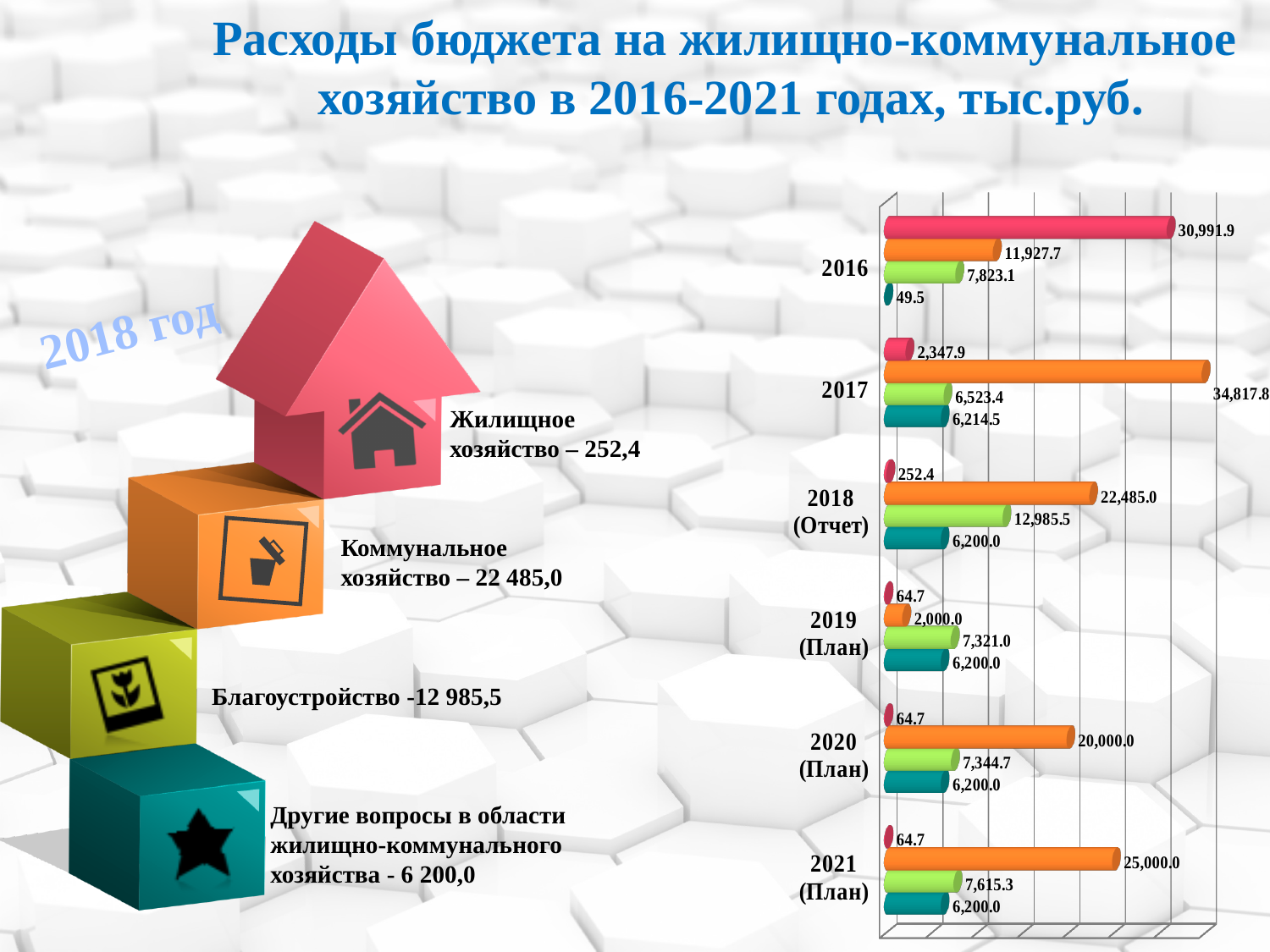
Which is larger: the red bar for 2016 or the orange bar for 2017? the orange bar for 2017 Do the orange bars rise or fall from 2019 (План) to 2021 (План)? rise In which year category is the orange bar the highest? 2017 What is the value of the orange bar for 2017 in the bar chart? 34,817.8 What is the value of the red bar for 2016 in the bar chart? 30,991.9 What kind of chart is shown on the right side of the slide? bar chart What is the value of the teal bar for 2021 (План) in the bar chart? 6,200.0 How many year categories does the bar chart show? 6 Which bar has the lowest value in the 2016 category? the teal bar (49.5) What is the value of the green bar for 2018 (Отчет) in the bar chart? 12,985.5 What is the total of the four bars for 2018 (Отчет)? 41,922.9 What is the difference between the orange bar for 2021 (План) and the orange bar for 2020 (План)? 5,000.0